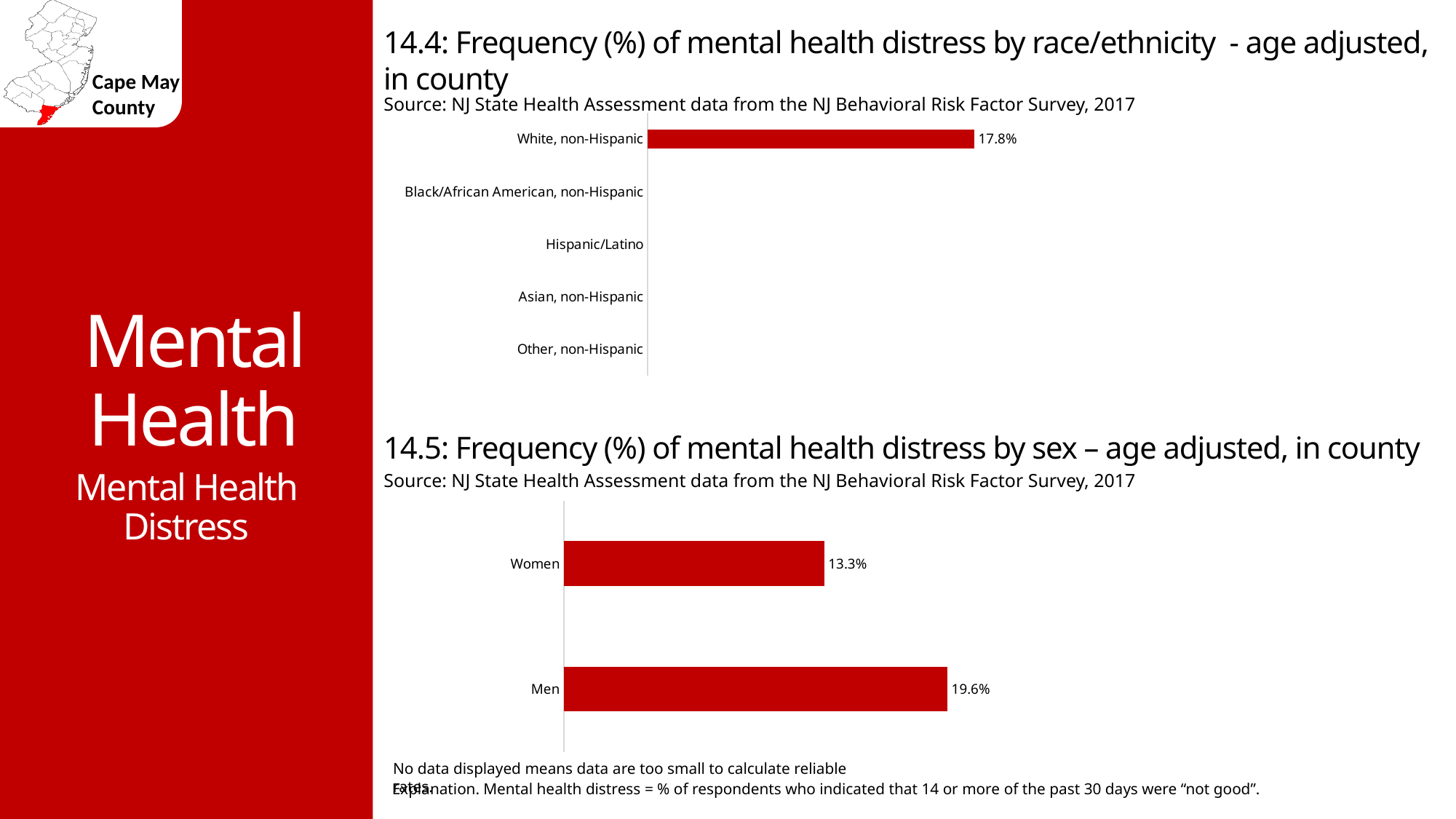
In chart 14.5 (mental health distress by sex), what is the value for Men? 19.6% In chart 14.4 (mental health distress by race/ethnicity), which category is the only one with a bar displayed? White, non-Hispanic What kind of chart is chart 14.4 (mental health distress by race/ethnicity)? Bar chart In chart 14.4 (mental health distress by race/ethnicity), what is the value for White, non-Hispanic? 17.8% In chart 14.5 (mental health distress by sex), how many categories are plotted? 2 In chart 14.5 (mental health distress by sex), what is the value for Women? 13.3% In chart 14.5 (mental health distress by sex), which category has the higher value? Men What kind of chart is chart 14.5 (mental health distress by sex)? Bar chart In chart 14.5 (mental health distress by sex), which category has the lower value? Women In chart 14.5 (mental health distress by sex), is the value for Women larger or smaller than the value for Men? Smaller In chart 14.5 (mental health distress by sex), what is the difference between the values for Men and Women? 6.3% In chart 14.4 (mental health distress by race/ethnicity), how many race/ethnicity categories are listed on the axis? 5